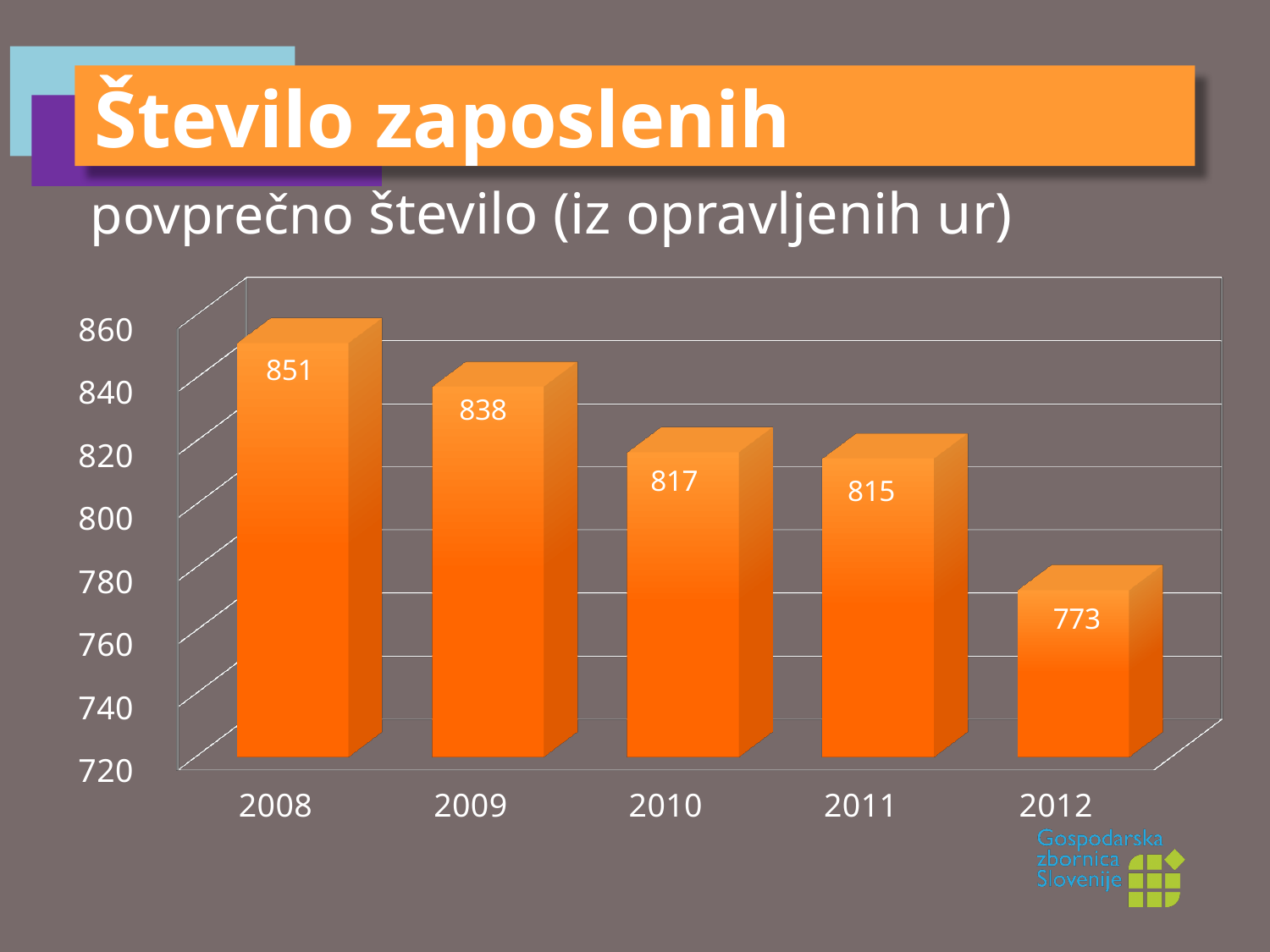
What is the difference between the values for 2008 and 2009? 13 What is the value for 2010? 817 Is the value for 2012 greater or less than 780? less How many years are shown on the x axis? 5 What is the value for 2008? 851 What is the difference between the values for 2011 and 2012? 42 Which is larger, the value for 2009 or the value for 2011? 2009 Do the values rise or fall from 2008 to 2012? fall What is the value for 2012? 773 Which year has the lowest value? 2012 What kind of chart is shown on the slide? bar chart Which year has the highest value? 2008